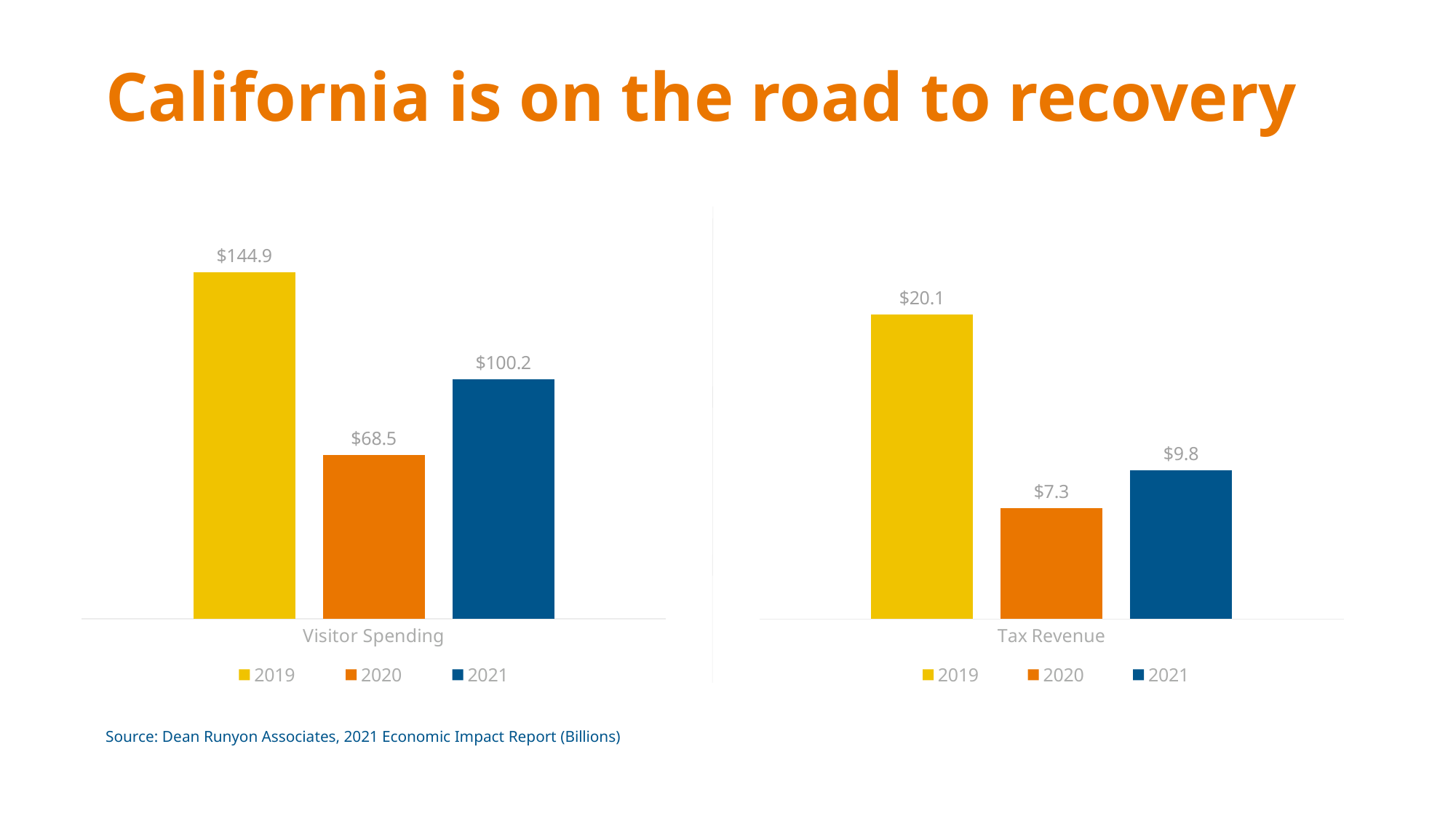
How many series does the legend of the Visitor Spending chart list? 3 In the Visitor Spending chart, which colour represents 2021? Blue In the Tax Revenue chart, what is the value for 2020? $7.3 In the Visitor Spending chart, what is the value for 2020? $68.5 In the Tax Revenue chart, which is larger, the value for 2020 or the value for 2021? 2021 In the Tax Revenue chart, which year has the lowest value? 2020 In the Visitor Spending chart, what is the difference between the 2019 and 2021 values? $44.7 In the Tax Revenue chart, what is the difference between the 2019 and 2020 values? $12.8 What kind of chart is the Tax Revenue chart? Bar chart In the Visitor Spending chart, what is the value for 2019? $144.9 In the Visitor Spending chart, which year has the highest value? 2019 In the Tax Revenue chart, what is the value for 2021? $9.8